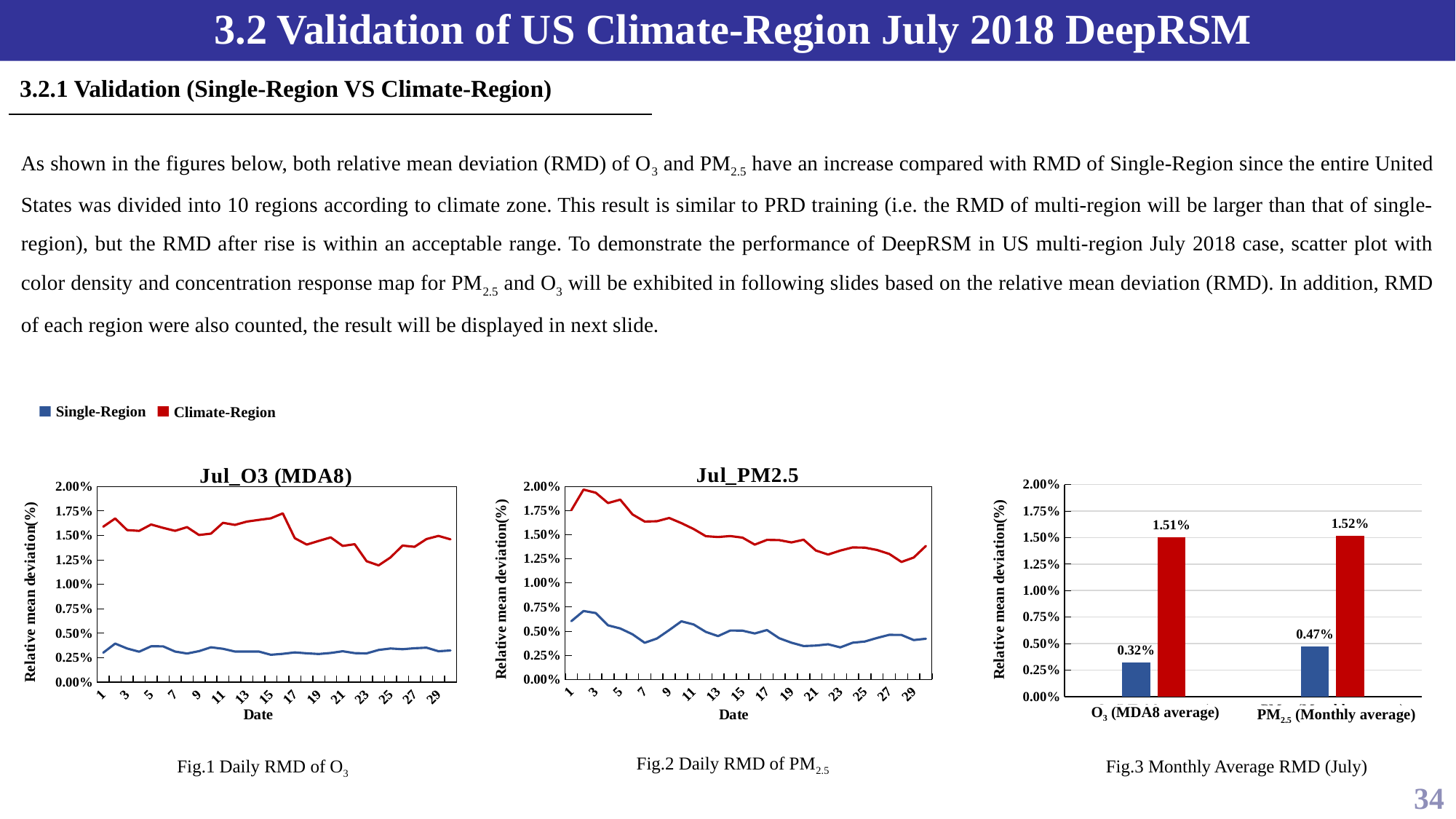
In Fig.3 Monthly Average RMD (July), which Single-Region value is larger: O3 (MDA8 average) or PM2.5 (Monthly average)? PM2.5 (Monthly average) In Fig.3 Monthly Average RMD (July), what is the difference between the Climate-Region and Single-Region values for PM2.5 (Monthly average)? 1.05% How many series does the shared legend list for the charts? 2 In Fig.3 Monthly Average RMD (July), what is the Climate-Region value for PM2.5 (Monthly average)? 1.52% What kind of chart is Fig.3 Monthly Average RMD (July)? Bar chart In Fig.3 Monthly Average RMD (July), what is the Climate-Region value for O3 (MDA8 average)? 1.51% In Fig.3 Monthly Average RMD (July), what is the Single-Region value for O3 (MDA8 average)? 0.32% What kind of chart is Fig.1 Jul_O3 (MDA8)? Line chart In Fig.3 Monthly Average RMD (July), which bar has the lowest value? Single-Region, O3 (MDA8 average) In Fig.2 Jul_PM2.5, is the Climate-Region value on date 3 greater or less than 1.75%? greater In Fig.1 Jul_O3 (MDA8), is the Single-Region value on date 1 greater or less than 0.50%? less In Fig.3 Monthly Average RMD (July), what is the difference between the Climate-Region and Single-Region values for O3 (MDA8 average)? 1.19%